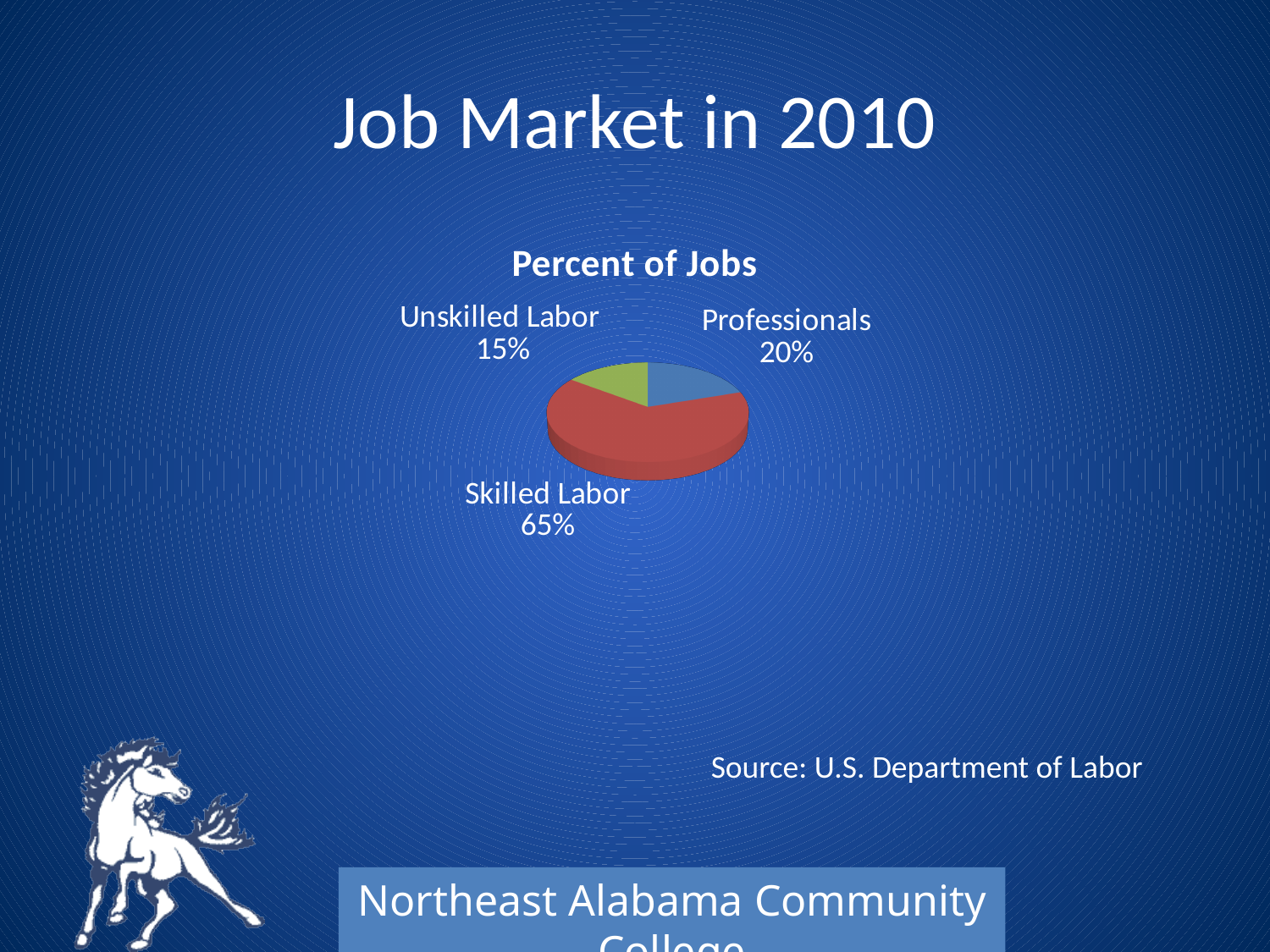
How many categories are shown in the pie chart? 3 What is the title of the chart? Percent of Jobs What percentage of jobs is Professionals? 20% Which category has the smallest share of jobs? Unskilled Labor What is the difference in percentage points between Professionals and Unskilled Labor? 5 Which category has the largest share of jobs? Skilled Labor Which is larger, the share for Professionals or the share for Unskilled Labor? Professionals What kind of chart is shown on the slide? Pie chart What percentage of jobs is Unskilled Labor? 15% What colour is the Skilled Labor slice? Red What is the difference in percentage points between Skilled Labor and Professionals? 45 What percentage of jobs is Skilled Labor? 65%